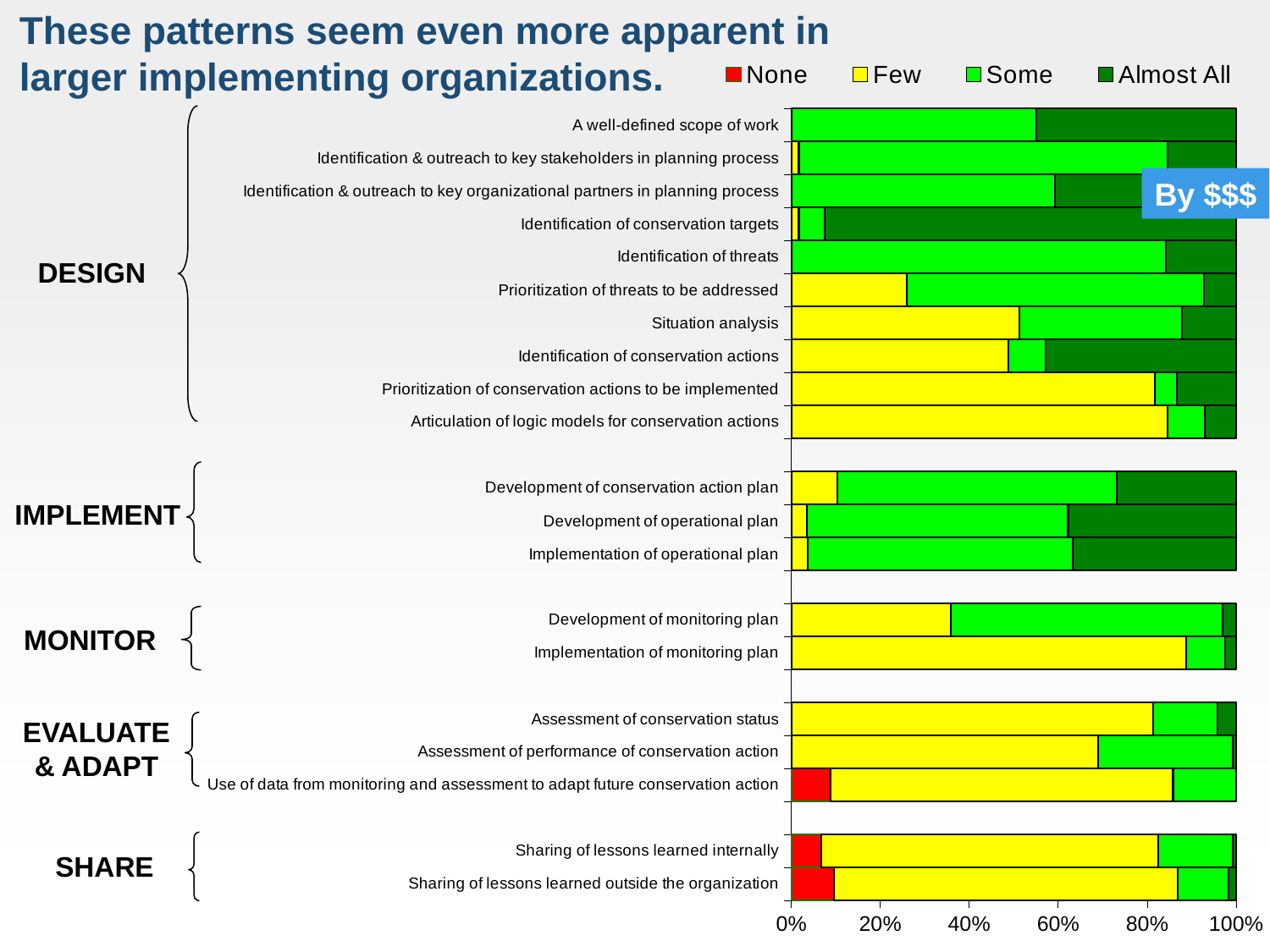
Which colour represents the 'None' series in the legend? Red Is the 'Few' value for 'Prioritization of threats to be addressed' greater or less than 20%? greater Which has the larger 'Few' segment: 'Implementation of monitoring plan' or 'Development of monitoring plan'? Implementation of monitoring plan How many series does the legend list? 4 What kind of chart is shown on the slide? Stacked bar chart Is the 'None' value for 'Sharing of lessons learned outside the organization' greater or less than 20%? less Is the 'Some' value for 'Identification of threats' greater or less than 80%? greater Which category has the largest 'Almost All' segment? Identification of conservation targets What label appears in the blue box at the top right of the chart? By $$$ How many categories (practices) are plotted in the chart? 20